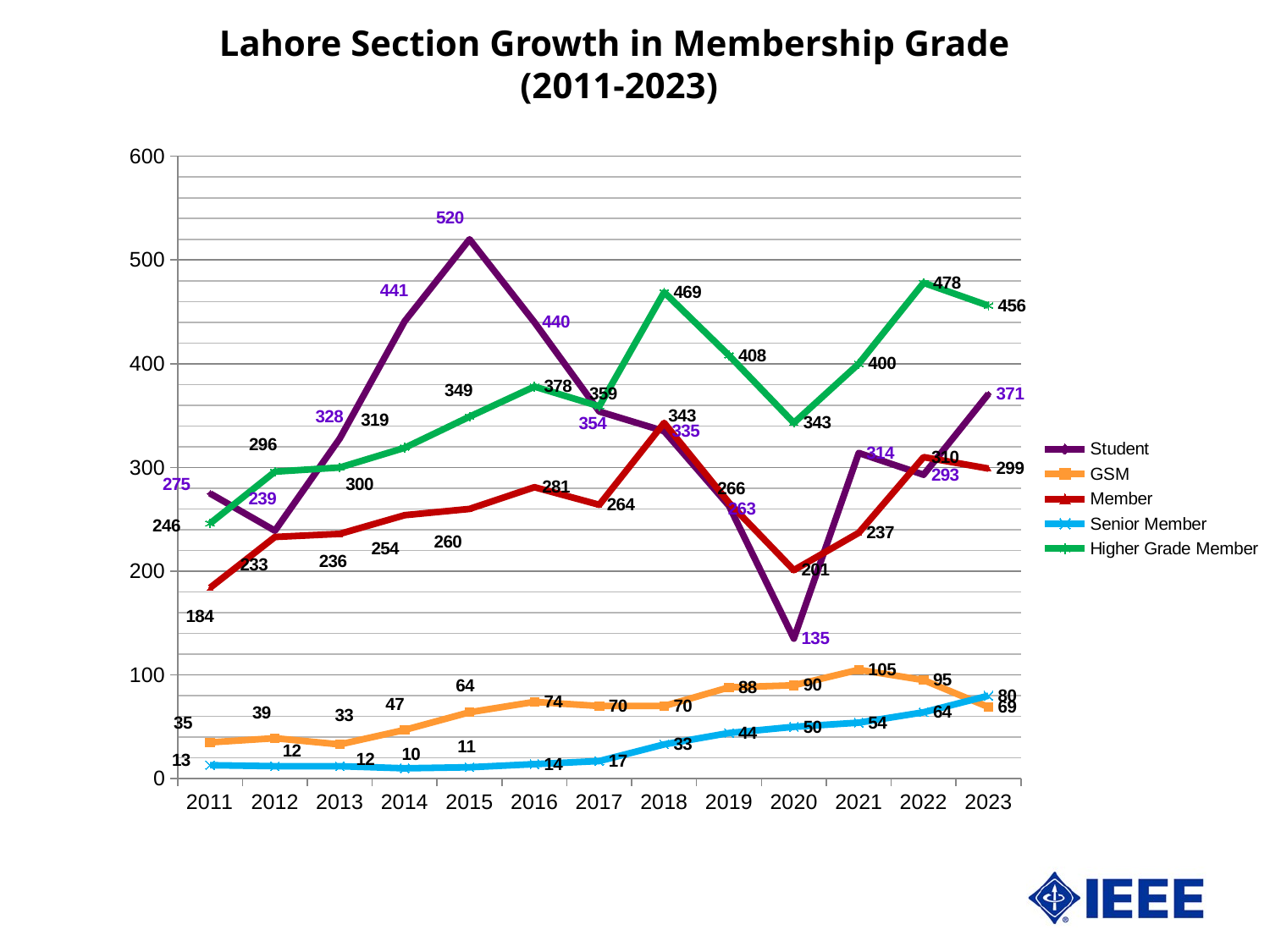
What is the Student value in 2015? 520 Does the Senior Member series rise or fall from 2018 to 2023? rise What is the Member value in 2011? 184 In which year is the Student series at its lowest? 2020 In which year does the Higher Grade Member series reach its highest value? 2022 In 2023, which is larger: the Student value or the Member value? Student What is the difference between the Higher Grade Member values in 2018 and 2020? 126 What kind of chart is shown on the slide? line chart What is the GSM value in 2021? 105 How many years are plotted along the x axis? 13 What is the title of the chart? Lahore Section Growth in Membership Grade (2011-2023) How many series does the legend list? 5